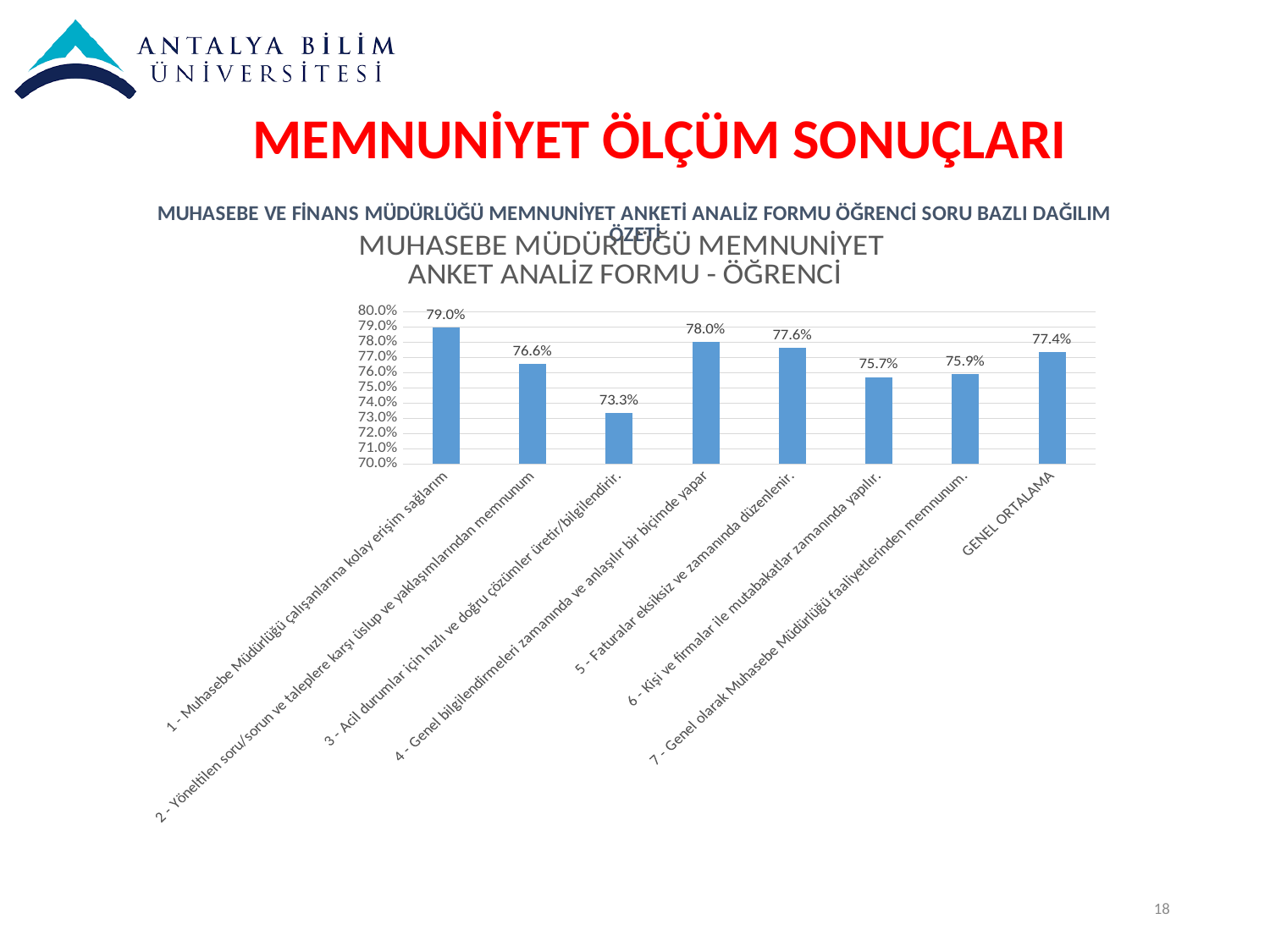
Which category has the lowest value? 3 - Acil durumlar için hızlı ve doğru çözümler üretir/bilgilendirir. Which is larger: the value for item 4 (Genel bilgilendirmeleri zamanında ve anlaşılır bir biçimde yapar) or item 2 (Yöneltilen soru/sorun ve taleplere karşı üslup ve yaklaşımlarından memnunum)? Item 4 What is the value for item 5 (Faturalar eksiksiz ve zamanında düzenlenir.)? 77.6% What is the title of the chart? MUHASEBE MÜDÜRLÜĞÜ MEMNUNİYET ANKET ANALİZ FORMU - ÖĞRENCİ What kind of chart is shown on the slide? Bar chart How many bars are shown in the chart? 8 What is the value for GENEL ORTALAMA? 77.4% Is the value for item 6 (Kişi ve firmalar ile mutabakatlar zamanında yapılır.) greater or less than 77.0%? less What is the value for item 3 (Acil durumlar için hızlı ve doğru çözümler üretir/bilgilendirir.)? 73.3% Which category has the highest value? 1 - Muhasebe Müdürlüğü çalışanlarına kolay erişim sağlarım What is the difference between the value for item 7 (Genel olarak Muhasebe Müdürlüğü faaliyetlerinden memnunum.) and item 6 (Kişi ve firmalar ile mutabakatlar zamanında yapılır.)? 0.2% What is the difference between the value for item 1 and the value for item 3? 5.7%